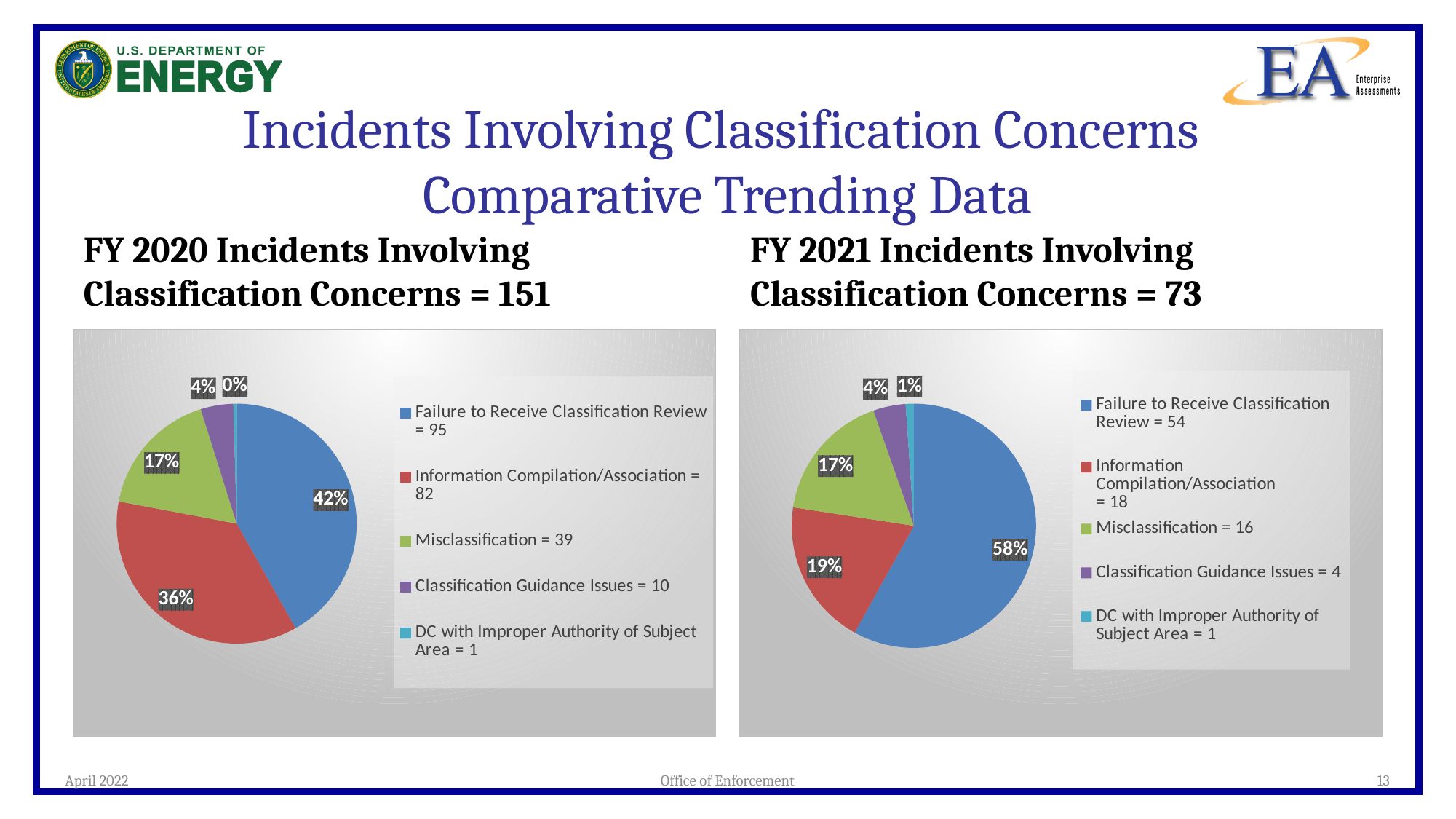
In the FY 2020 pie chart, what percentage share does Failure to Receive Classification Review have? 42% What type of chart is used for the FY 2020 Incidents Involving Classification Concerns data? pie chart In the FY 2021 pie chart, how many incidents does the legend give for Classification Guidance Issues? 4 In the FY 2021 pie chart, what percentage share does Failure to Receive Classification Review have? 58% In the FY 2021 pie chart, what percentage share does Information Compilation/Association have? 19% In the FY 2020 pie chart, how many incidents does the legend give for Misclassification? 39 In the FY 2021 pie chart, which is larger: the share for Misclassification or the share for Classification Guidance Issues? Misclassification How many categories does the legend of the FY 2021 pie chart list? 5 In the FY 2021 pie chart, which category has the largest share? Failure to Receive Classification Review In the FY 2020 pie chart, what is the difference between the incident counts for Failure to Receive Classification Review and Information Compilation/Association? 13 In the FY 2020 pie chart, which category has the smallest share? DC with Improper Authority of Subject Area